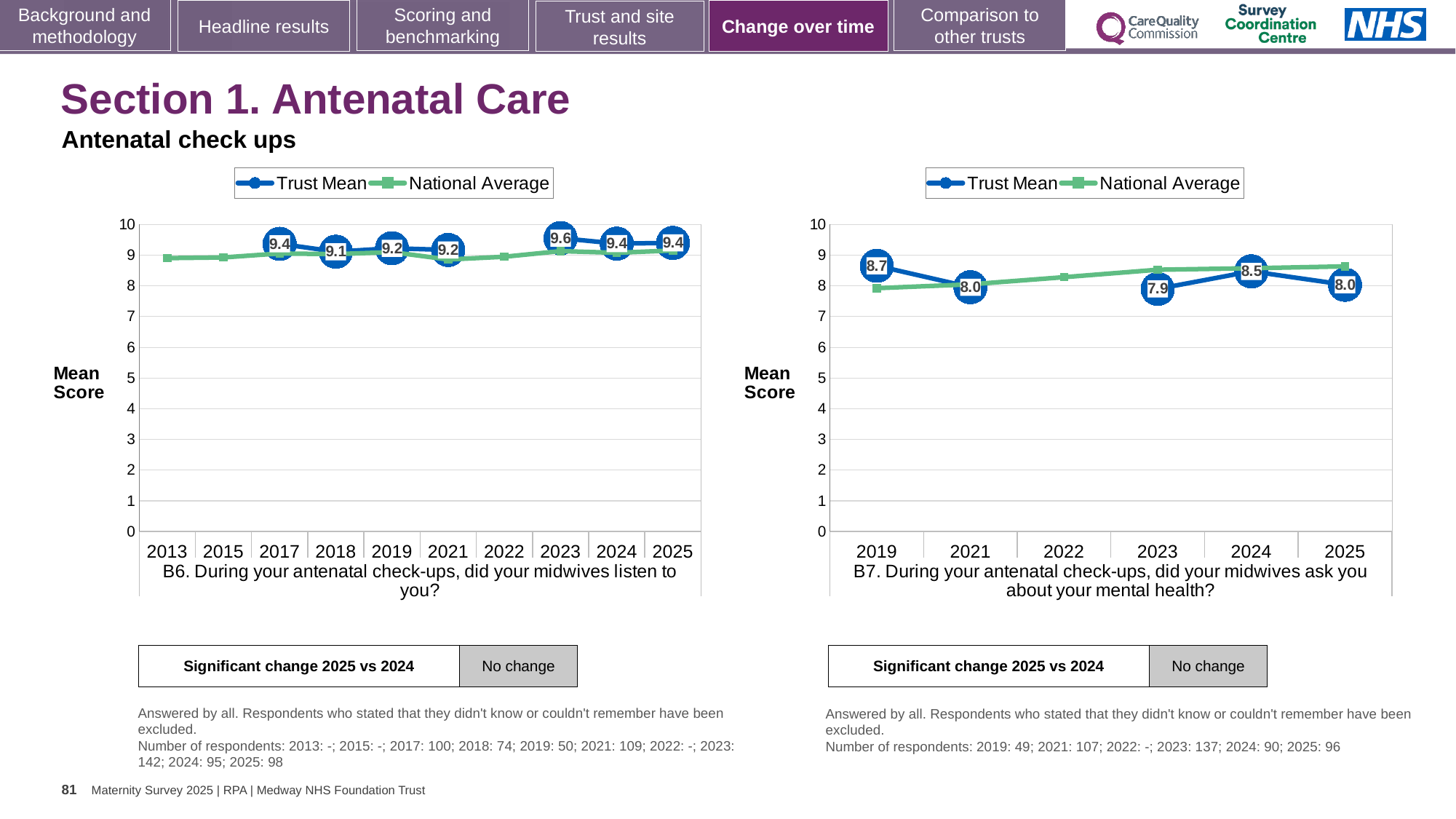
In the B6 chart (left), what is the difference between the Trust Mean in 2023 and in 2018? 0.5 In the B6 chart (left), which year has the highest Trust Mean? 2023 What type of chart is the B6 chart (left)? Line chart In the B6 chart (left), what is the Trust Mean for 2018? 9.1 In the B7 chart (right), which year has the lowest Trust Mean? 2023 In the B6 chart (left), what is the Trust Mean for 2023? 9.6 How many series does the legend of the B7 chart (right) list? 2 In the B7 chart (right), is the National Average for 2019 greater or less than 9? less In the B6 chart (left), how many years are shown on the x axis? 10 In the B7 chart (right), what is the Trust Mean for 2019? 8.7 In the B6 chart (left), which year has the lowest labelled Trust Mean? 2018 In the B7 chart (right), is the Trust Mean higher in 2024 or in 2025? 2024